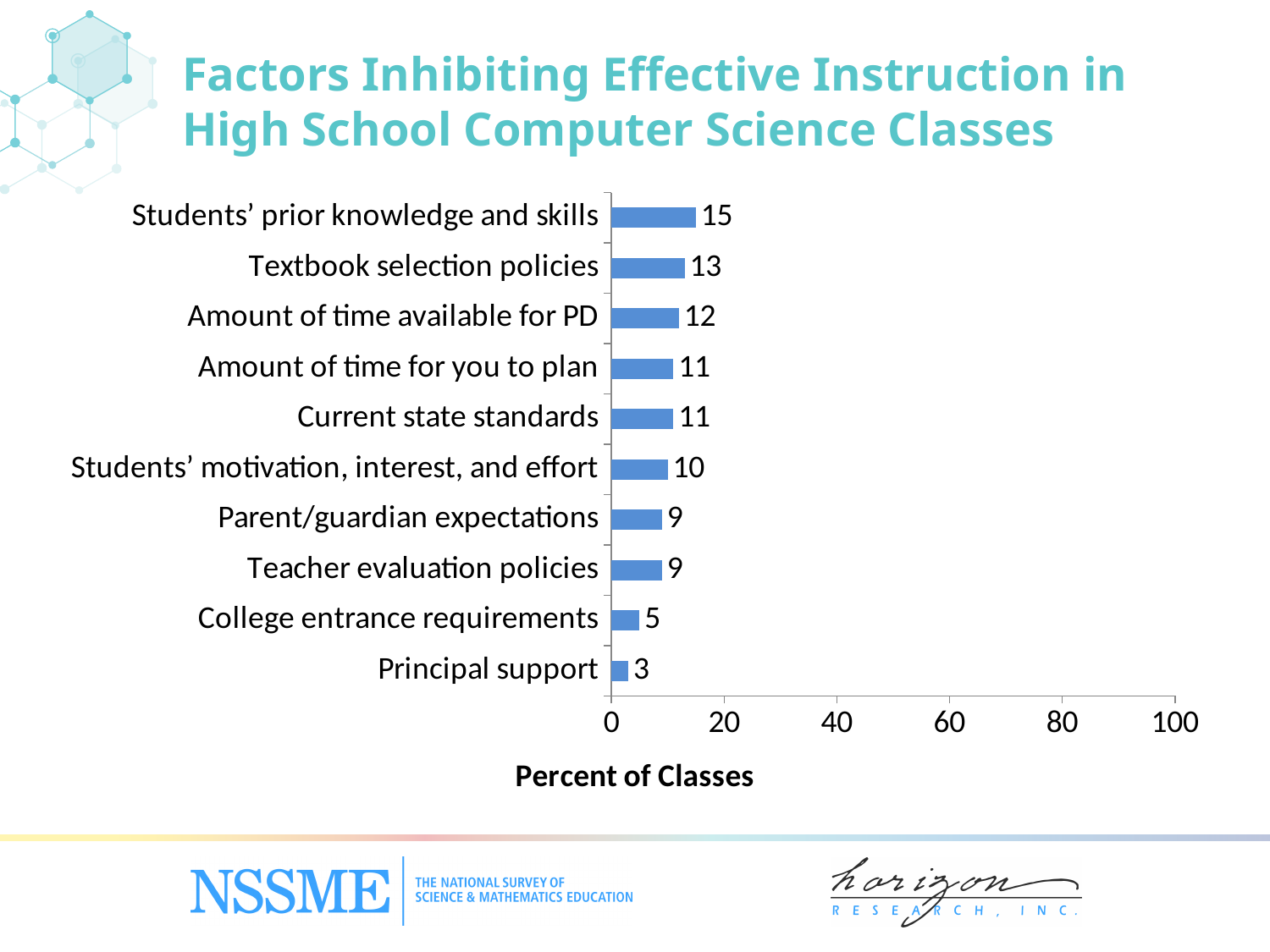
What percent of classes reported students' prior knowledge and skills as a factor inhibiting effective instruction? 15 Which factor has the lowest percent of classes? Principal support What kind of chart is shown on the slide? Bar chart How many factors are shown in the chart? 10 What is the difference between the values for Students' prior knowledge and skills and Principal support? 12 What is the label of the horizontal axis? Percent of Classes What is the value for Principal support? 3 Which is larger, the value for Amount of time available for PD or the value for Students' motivation, interest, and effort? Amount of time available for PD What is the value for Textbook selection policies? 13 What is the value for College entrance requirements? 5 Is the value for Students' prior knowledge and skills greater or less than 20? less Which factor has the highest percent of classes? Students' prior knowledge and skills